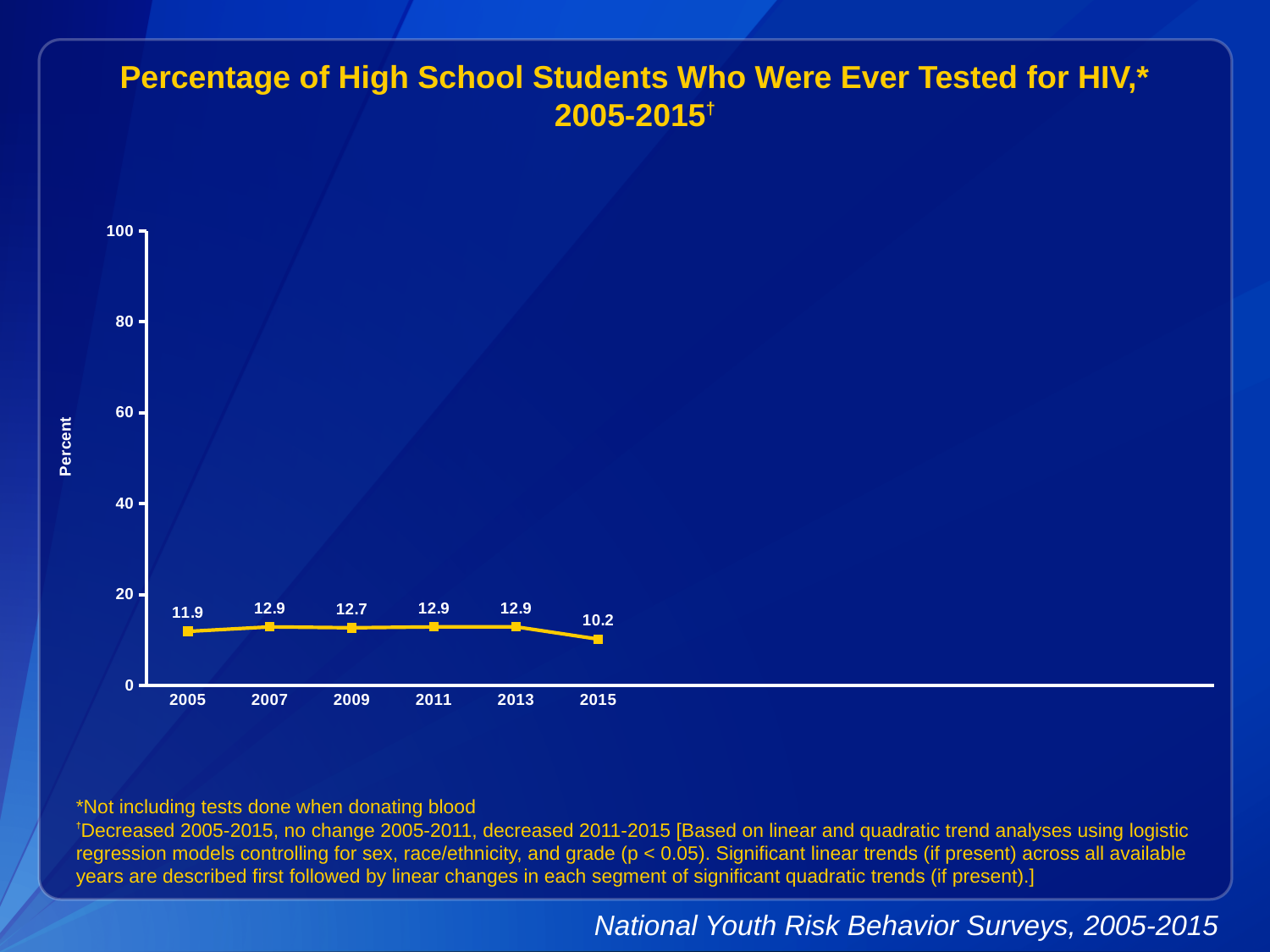
What kind of chart is shown on the slide? line chart Does the value rise or fall from 2013 to 2015? fall What percentage of high school students were ever tested for HIV in 2005? 11.9 Which year has the lowest value on the chart? 2015 What is the label on the vertical axis? Percent What is the value plotted for 2015? 10.2 Is the value for 2011 greater or less than 20? less What is the difference between the 2013 value and the 2015 value? 2.7 What is the difference between the 2007 value and the 2005 value? 1.0 How many years are plotted on the chart? 6 What is the value plotted for 2009? 12.7 Which is larger, the value for 2005 or the value for 2015? 2005